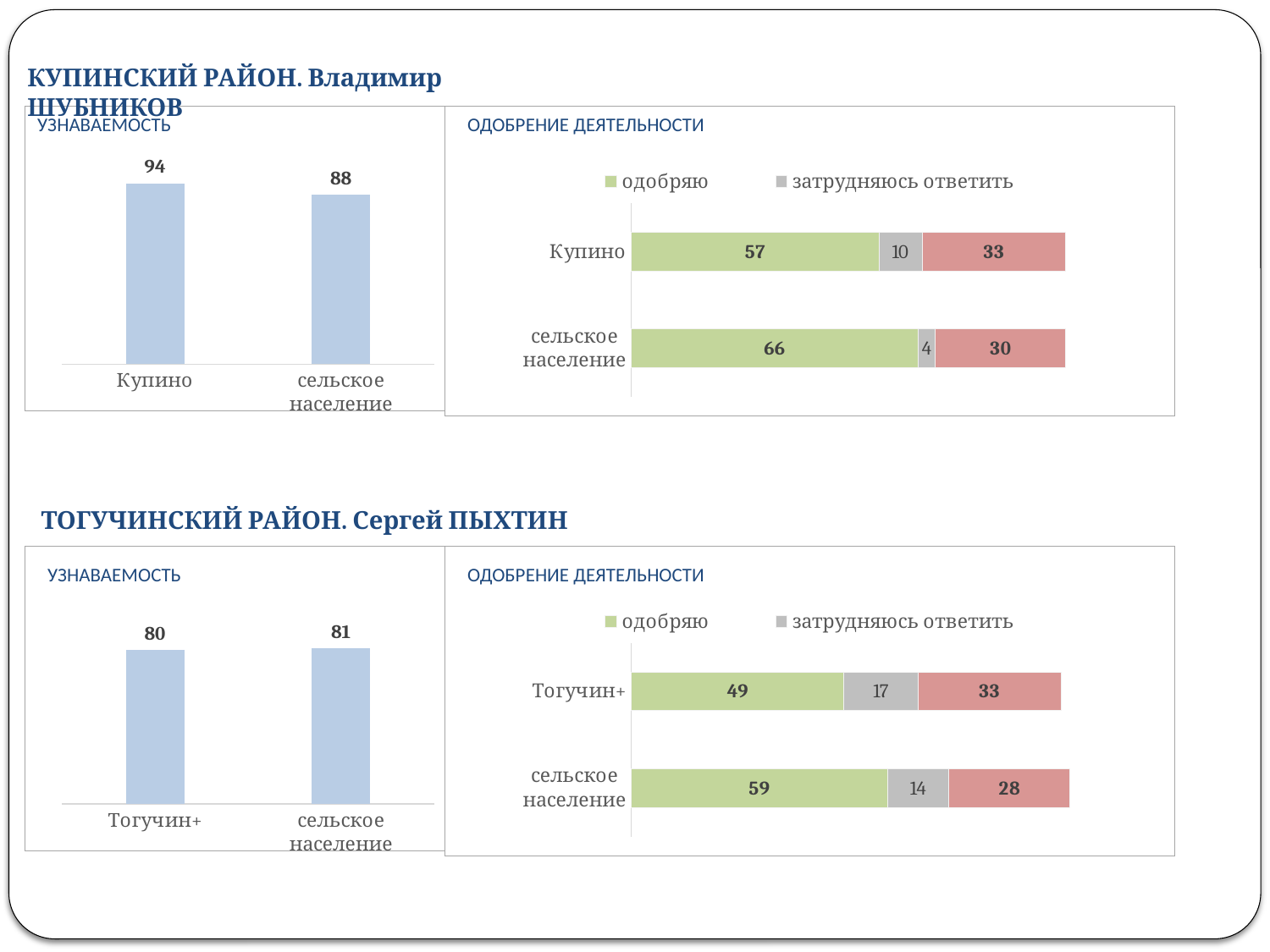
In the УЗНАВАЕМОСТЬ chart for ТОГУЧИНСКИЙ РАЙОН (bottom left), which category has the higher value, Тогучин+ or сельское население? сельское население In the ОДОБРЕНИЕ ДЕЯТЕЛЬНОСТИ chart for КУПИНСКИЙ РАЙОН (top right), what is the total of the stacked bar for Купино? 100 In the УЗНАВАЕМОСТЬ chart for КУПИНСКИЙ РАЙОН (top left), what is the value for Купино? 94 In the ОДОБРЕНИЕ ДЕЯТЕЛЬНОСТИ chart for ТОГУЧИНСКИЙ РАЙОН (bottom right), what is the одобряю value for Тогучин+? 49 What kind of chart is the УЗНАВАЕМОСТЬ chart for КУПИНСКИЙ РАЙОН (top left)? bar chart In the ОДОБРЕНИЕ ДЕЯТЕЛЬНОСТИ chart for КУПИНСКИЙ РАЙОН (top right), what is the затрудняюсь ответить value for Купино? 10 In the УЗНАВАЕМОСТЬ chart for ТОГУЧИНСКИЙ РАЙОН (bottom left), what is the value for Тогучин+? 80 In the ОДОБРЕНИЕ ДЕЯТЕЛЬНОСТИ chart for КУПИНСКИЙ РАЙОН (top right), what is the одобряю value for сельское население? 66 How many categories are shown in the ОДОБРЕНИЕ ДЕЯТЕЛЬНОСТИ chart for КУПИНСКИЙ РАЙОН (top right)? 2 In the УЗНАВАЕМОСТЬ chart for КУПИНСКИЙ РАЙОН (top left), what is the difference between Купино and сельское население? 6 How many entries does the legend list in the ОДОБРЕНИЕ ДЕЯТЕЛЬНОСТИ chart for ТОГУЧИНСКИЙ РАЙОН (bottom right)? 2 In the ОДОБРЕНИЕ ДЕЯТЕЛЬНОСТИ chart for ТОГУЧИНСКИЙ РАЙОН (bottom right), what is the difference between the одобряю values for сельское население and Тогучин+? 10